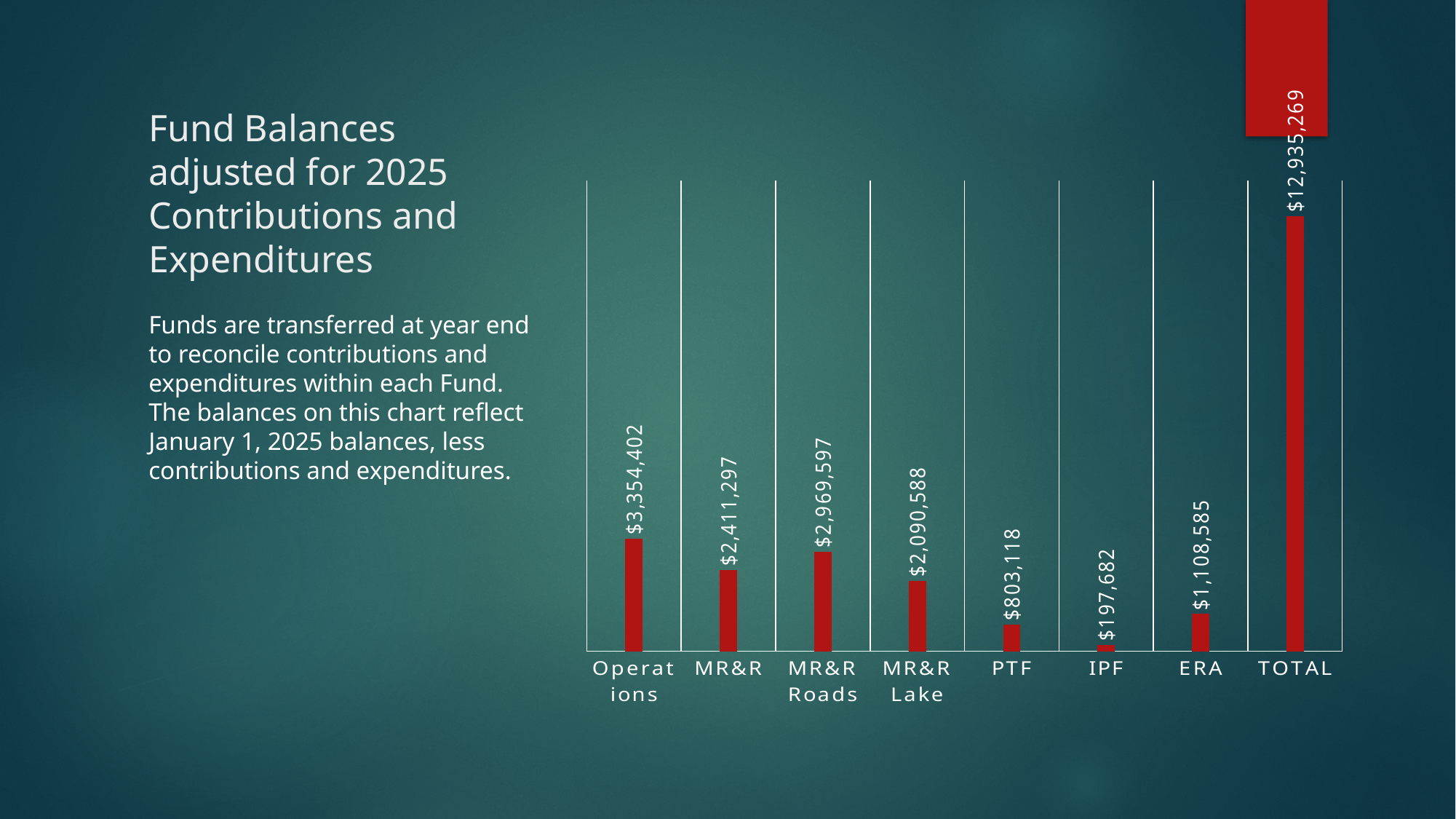
Excluding the TOTAL bar, which fund has the highest balance? Operations What is the value for Operations? $3,354,402 What is the difference between the values for PTF and IPF? $605,436 Which is larger, the value for ERA or the value for PTF? ERA What is the difference between the values for Operations and MR&R? $943,105 What is the value for IPF? $197,682 Which category has the lowest value? IPF What colour are the bars in the chart? Red What kind of chart is shown on the slide? Bar chart What is the value for TOTAL? $12,935,269 What is the value for MR&R Roads? $2,969,597 How many categories are shown on the x axis? 8